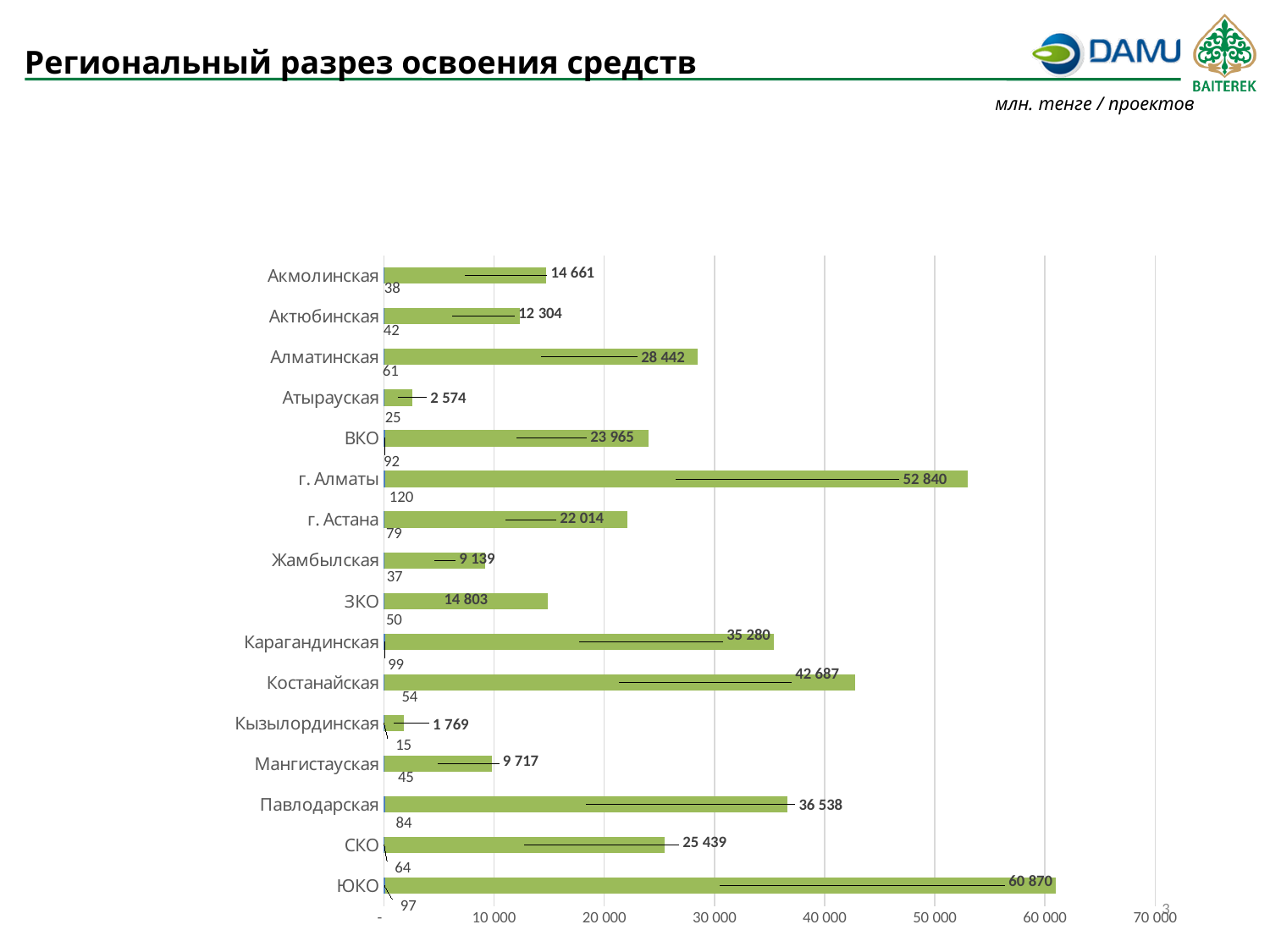
Which region has the lowest value in million tenge? Кызылординская What is the value in million tenge for г. Алматы? 52 840 Which region has the highest number of projects? г. Алматы How many projects are shown for ВКО? 92 Which has a larger value in million tenge, Павлодарская or Карагандинская? Павлодарская What kind of chart is shown on the slide? bar chart What is the difference in million tenge between ЮКО and г. Алматы? 8 030 Which region has the highest value in million tenge? ЮКО What is the title of the slide? Региональный разрез освоения средств What is the value in million tenge for Костанайская? 42 687 How many regions are shown on the chart? 16 Is the value for Алматинская greater or less than 30 000? less